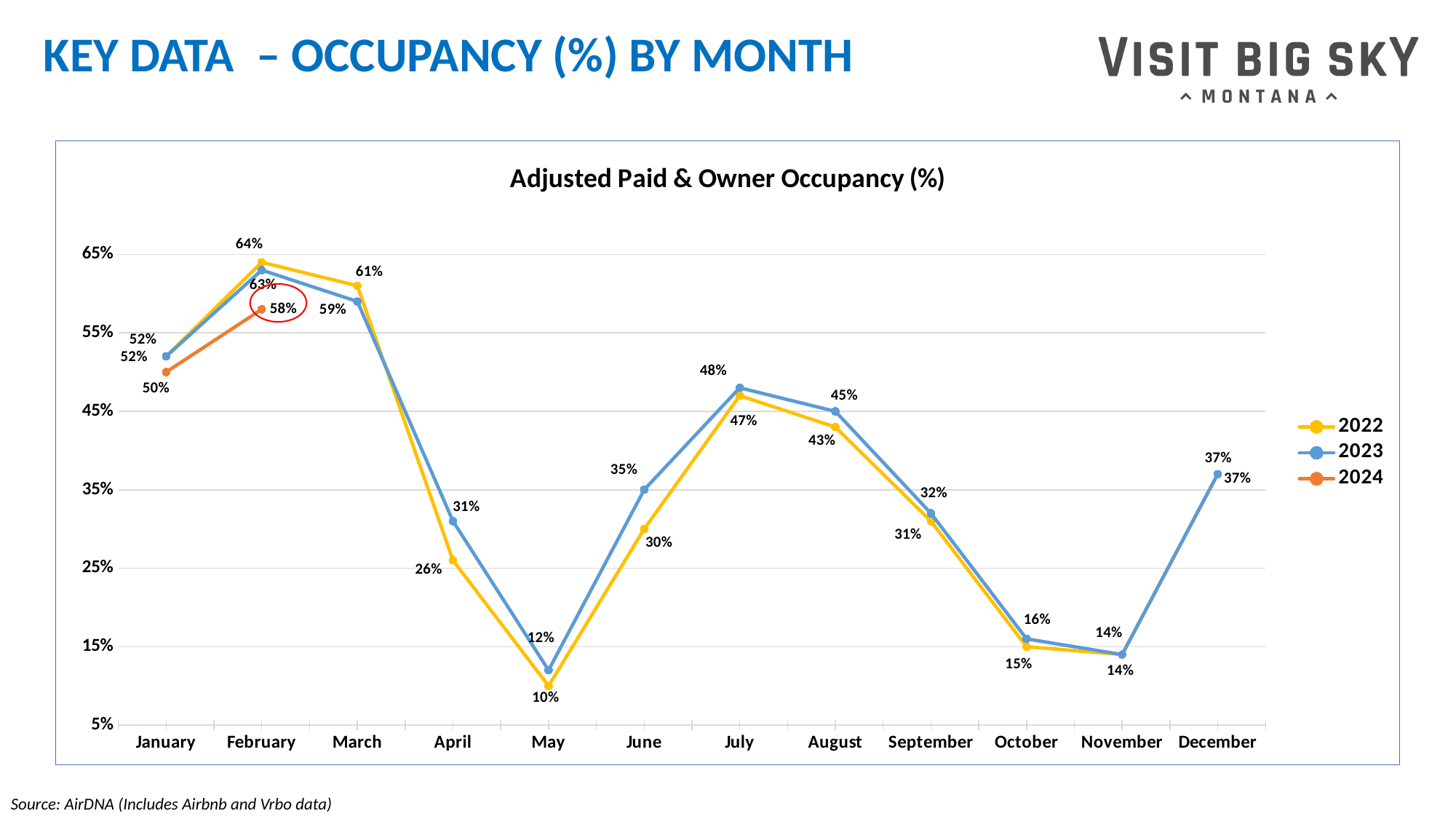
In which month is the 2022 occupancy lowest? May What is the 2023 occupancy value for April? 31% What is the difference between the 2023 and 2022 occupancy values in April? 5% In which month is the 2022 occupancy highest? February What is the 2022 occupancy value for May? 10% What is the 2022 occupancy value for February? 64% Which series has the higher occupancy in June, 2022 or 2023? 2023 How many months are shown on the x axis? 12 What kind of chart is shown on the slide? Line chart How many series does the legend list? 3 What is the 2024 occupancy value for February? 58% What is the 2024 occupancy value for January? 50%